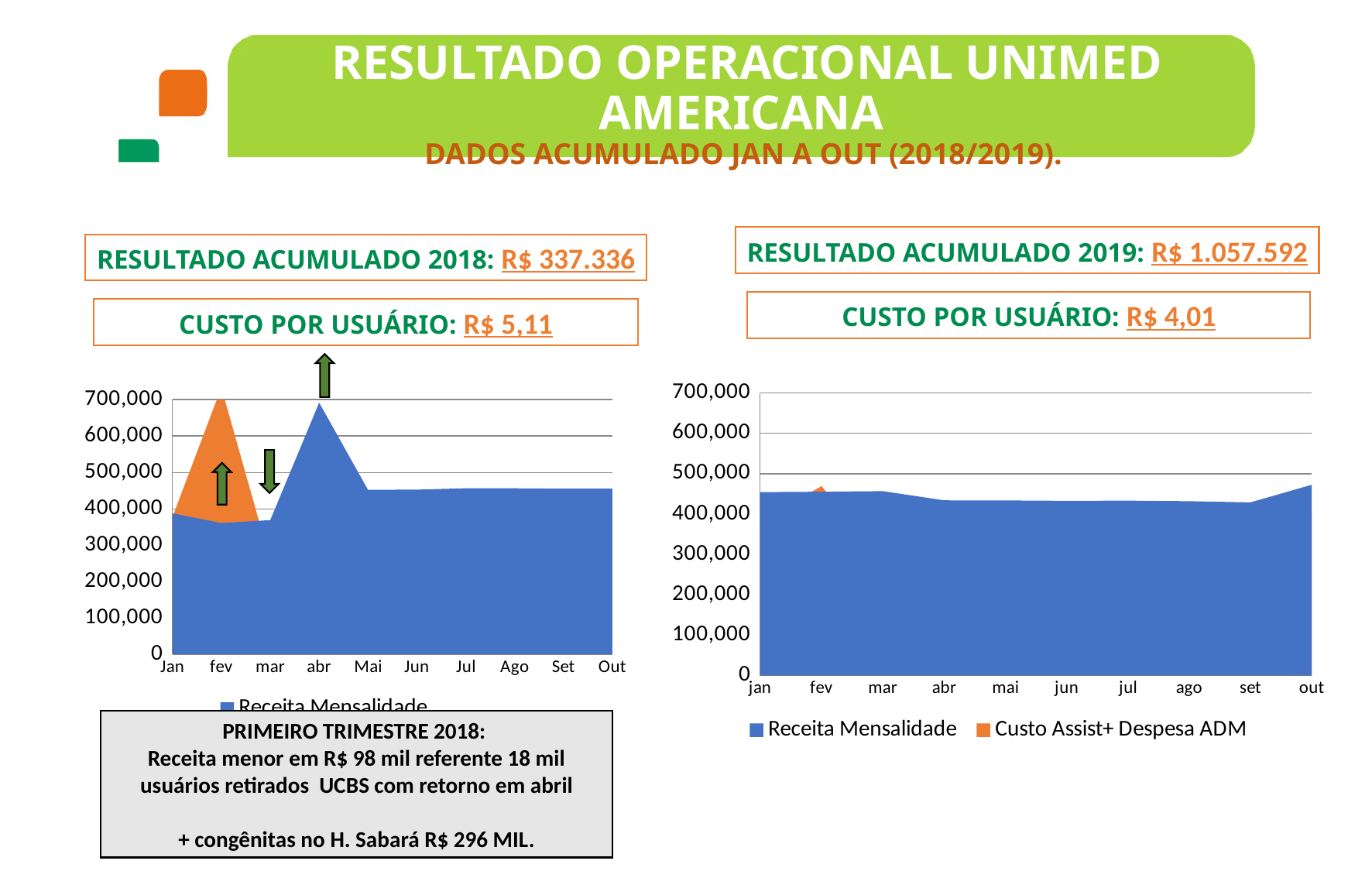
In the left chart (2018), is the Receita Mensalidade value for abr greater or less than 600,000? greater In the right chart (2019), is the Receita Mensalidade value for out greater or less than 400,000? greater In the left chart (2018), which month has the highest Receita Mensalidade value? abr In the left chart (2018), is the Receita Mensalidade value for abr larger or smaller than the value for Mai? larger In the left chart (2018), how many months are shown on the x axis? 10 How many series does the legend of the right chart (2019) list? 2 What kind of chart is the right chart (2019)? area chart In the left chart (2018), is the Receita Mensalidade value for Jun greater or less than 400,000? greater In the right chart (2019), how many months are shown on the x axis? 10 What kind of chart is the left chart (2018)? area chart In the right chart (2019), which series is shown in orange according to the legend? Custo Assist+ Despesa ADM